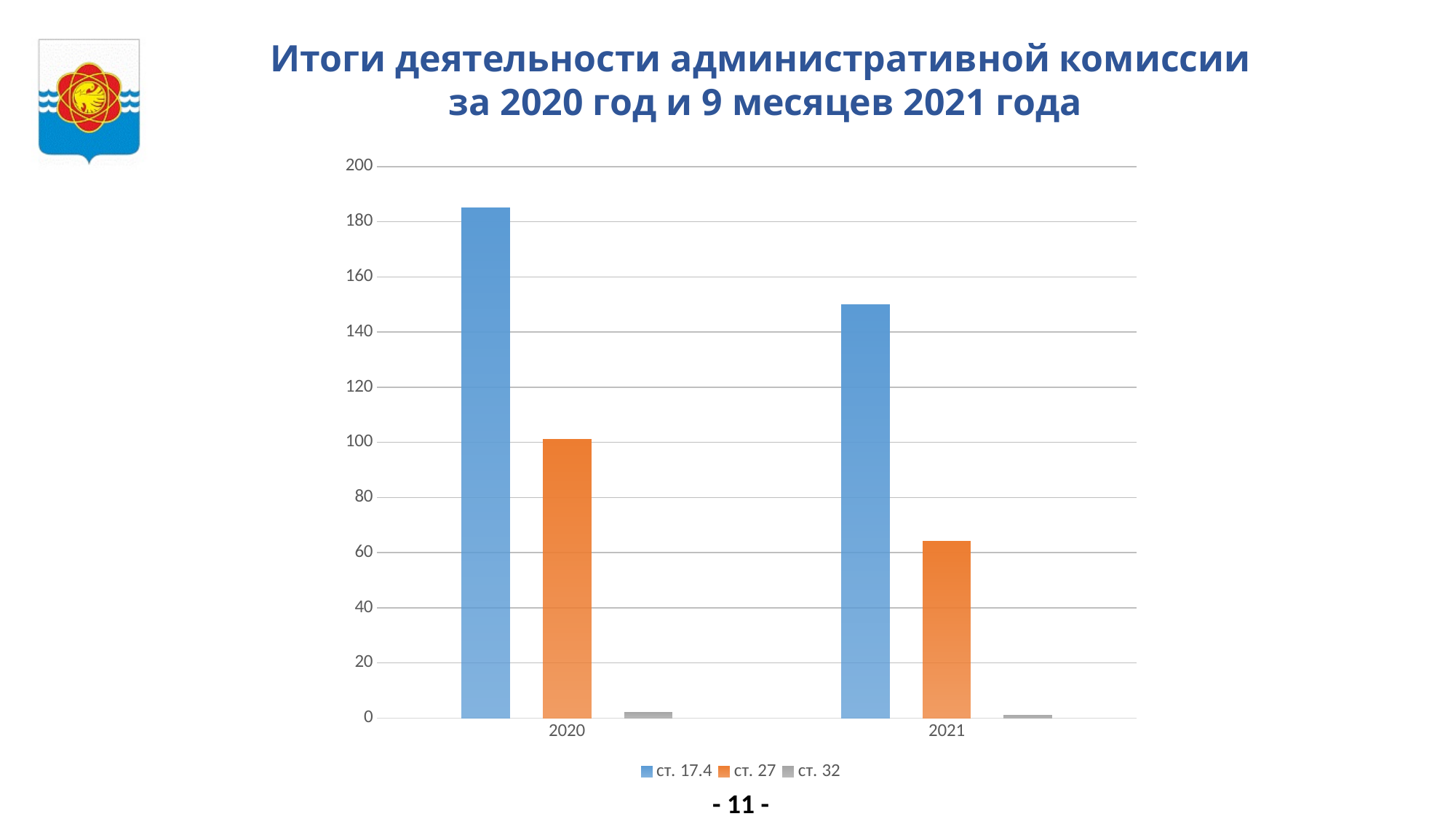
How many categories are shown on the x axis? 2 Is the value for ст. 27 in 2020 greater or less than 80? greater Which is larger for ст. 27: the value in 2020 or in 2021? 2020 Is the value for ст. 27 in 2021 greater or less than 80? less Is the value for ст. 17.4 in 2021 greater or less than 140? greater What kind of chart is shown on the slide? bar chart Which series has the lowest value in 2021? ст. 32 Which series has the highest value in 2020? ст. 17.4 Does the value for ст. 17.4 rise or fall from 2020 to 2021? fall How many series does the legend list? 3